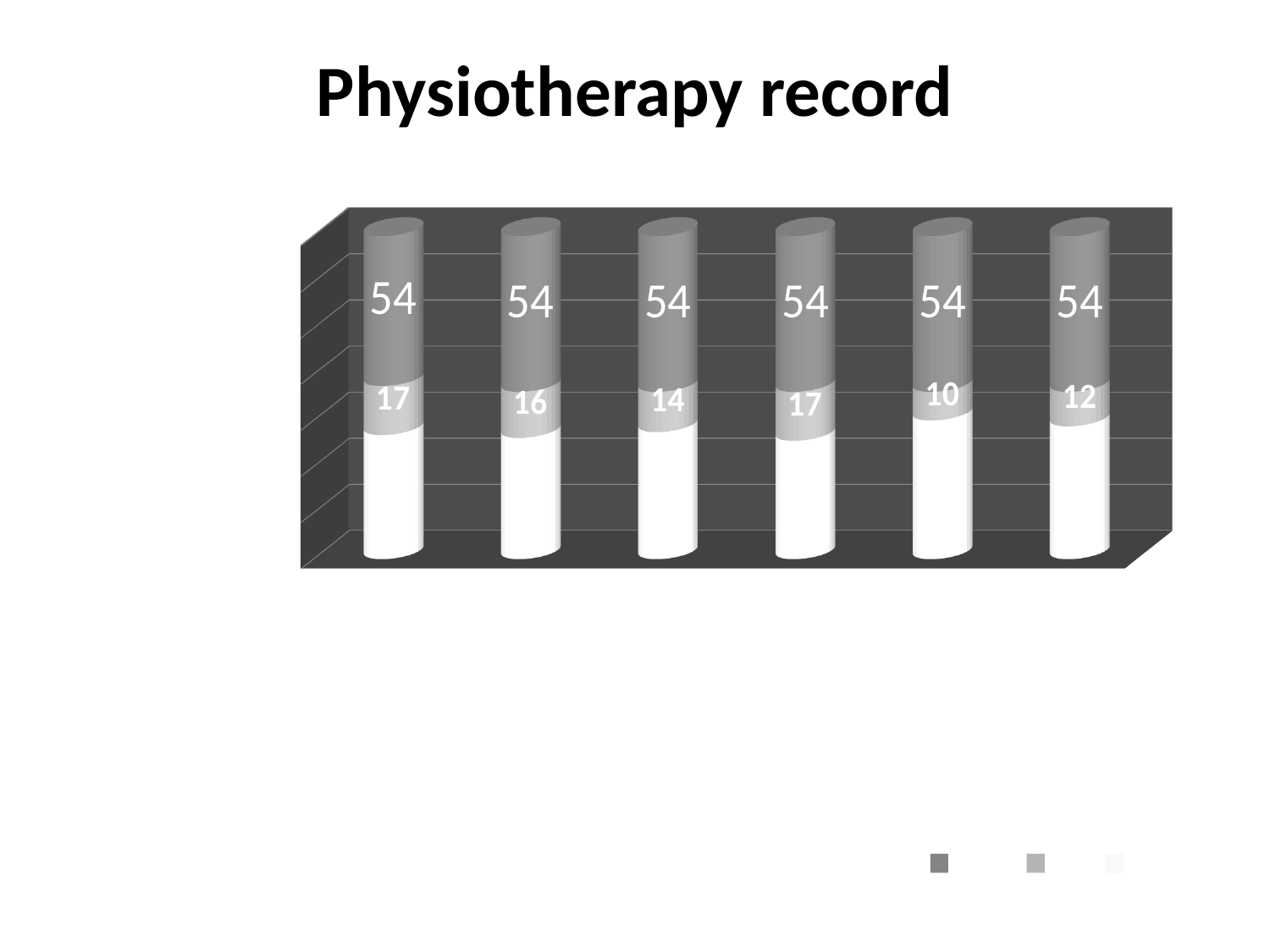
What is the difference between the middle-segment values of the first bar (17) and the fifth bar (10)? 7 What value is labelled on the middle segment of the third bar from the left? 14 What value is labelled on the top (dark grey) segment of the first bar from the left? 54 What is the title of the slide's chart? Physiotherapy record Which bar has the lowest labelled value in its middle segment? the fifth bar from the left What value is labelled on the middle (light grey) segment of the first bar from the left? 17 How many bars are plotted in the chart? 6 What value is labelled on the middle segment of the second bar from the left? 16 What value is labelled on the middle segment of the fifth bar from the left? 10 What kind of chart is shown on the slide? stacked bar chart What value is labelled on the middle segment of the sixth bar from the left? 12 How many series does the legend show? 3